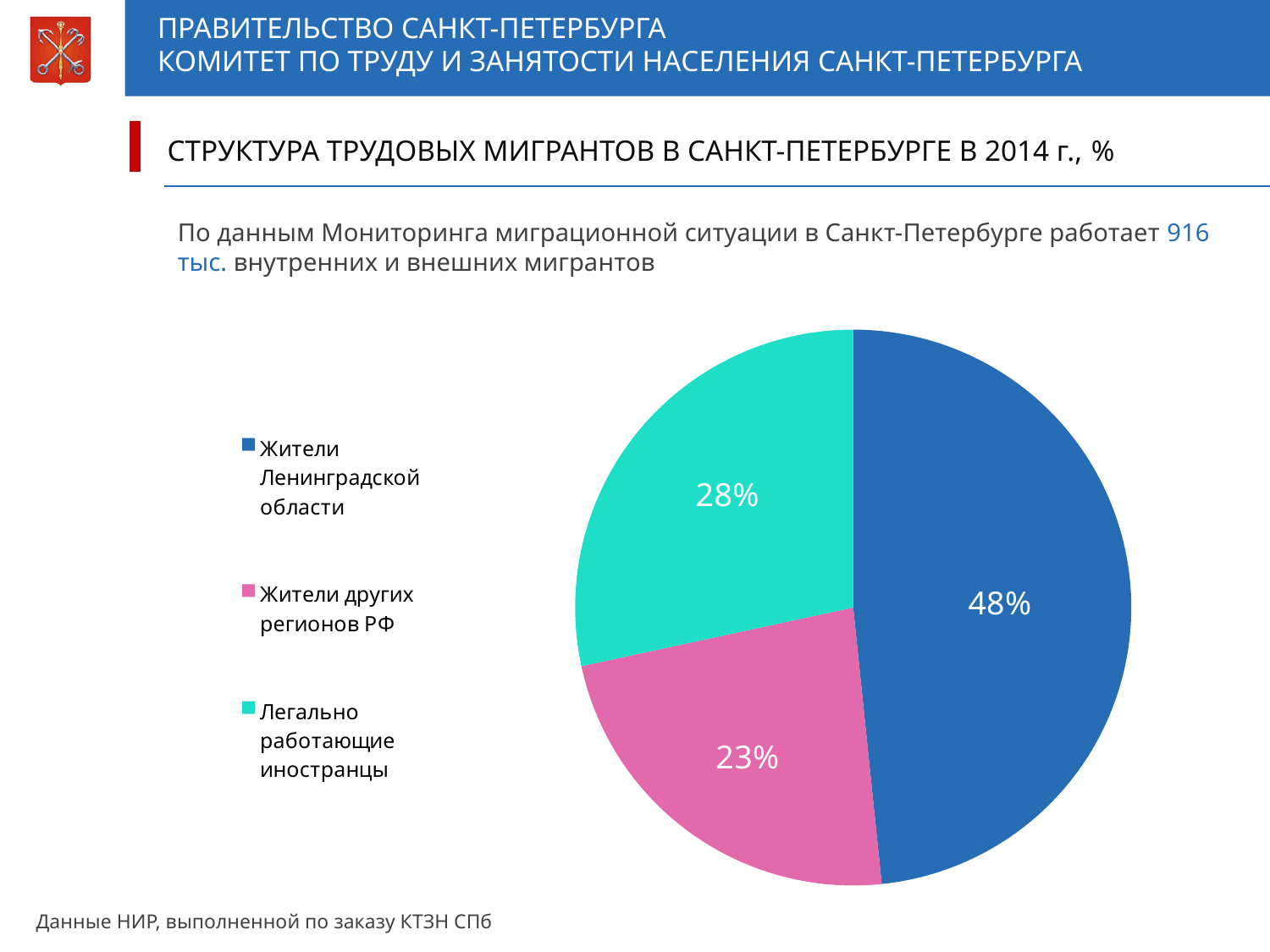
What share of labour migrants are residents of Leningrad Oblast (Жители Ленинградской области)? 48% What is the title of the chart on the slide? СТРУКТУРА ТРУДОВЫХ МИГРАНТОВ В САНКТ-ПЕТЕРБУРГЕ В 2014 г., % How many entries does the legend list? 3 What is the difference in percentage points between the share of Leningrad Oblast residents and the share of legally working foreigners? 20 Which category has the largest share of the pie? Жители Ленинградской области What share of labour migrants are residents of other regions of the Russian Federation (Жители других регионов РФ)? 23% What type of chart is shown on the slide? pie chart Which is larger: the share of legally working foreigners or the share of residents of other regions of the RF? Легально работающие иностранцы What colour is the slice for Жители других регионов РФ? pink What share of labour migrants are legally working foreigners (Легально работающие иностранцы)? 28% How many slices does the pie chart have? 3 Which category has the smallest share of the pie? Жители других регионов РФ